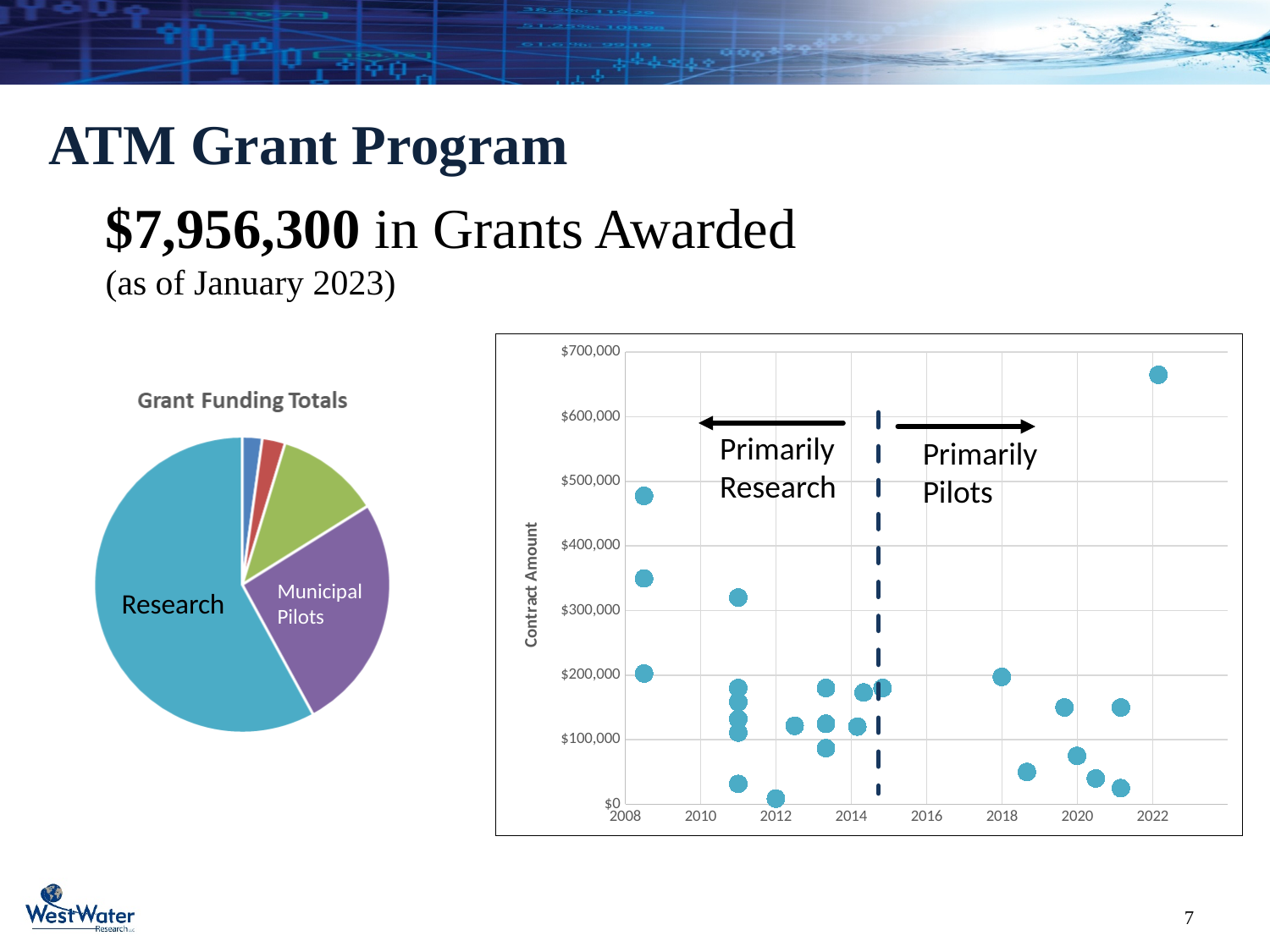
In the Grant Funding Totals pie chart, which slice is larger, Research or Municipal Pilots? Research In the scatter chart on the right, is the lowest point plotted near 2012 greater or less than $100,000? less In the Grant Funding Totals pie chart, which labeled slice is the largest? Research What kind of chart is the chart on the right showing Contract Amount by year? scatter chart In the scatter chart on the right, is the highest point plotted near 2008 greater or less than $500,000? less How many slices does the Grant Funding Totals pie chart have? 5 In the scatter chart on the right, what is the label of the vertical axis? Contract Amount What kind of chart is the Grant Funding Totals chart on the left? pie chart What is the title of the pie chart on the left? Grant Funding Totals In the scatter chart on the right, around which year is the highest Contract Amount plotted? 2022 In the scatter chart on the right, is the highest point plotted near 2011 greater or less than $300,000? greater